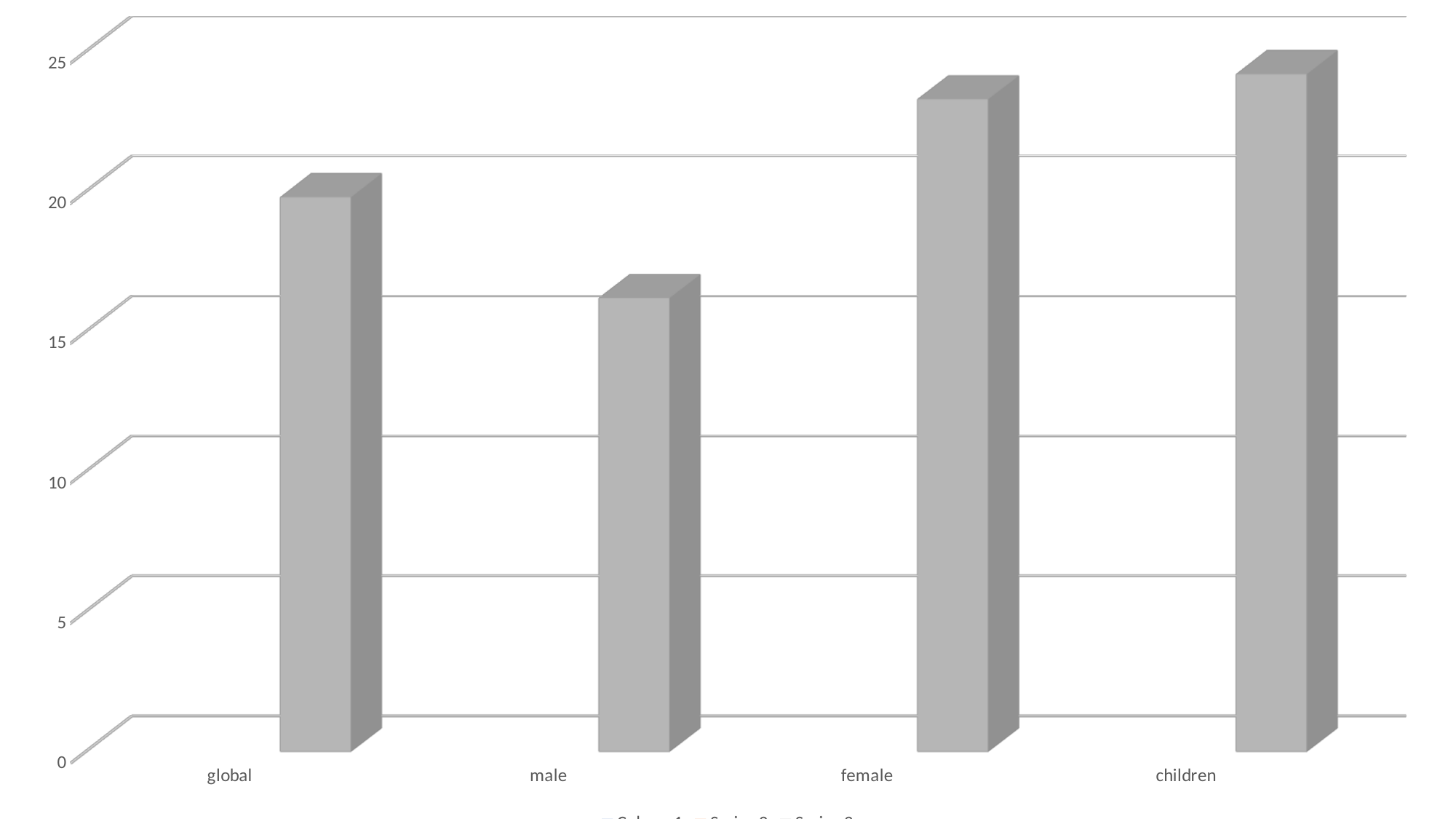
Is the value for male greater or less than 10? greater Is the value for global greater or less than 15? greater Does the value rise or fall from global to male? fall Is the value for male greater or less than 20? less How many categories are shown on the x axis? 4 What kind of chart is shown on the slide? bar chart Which is larger, the value for global or the value for male? global Which category has the highest bar? children Which category has the lowest bar? male Which is larger, the value for female or the value for global? female